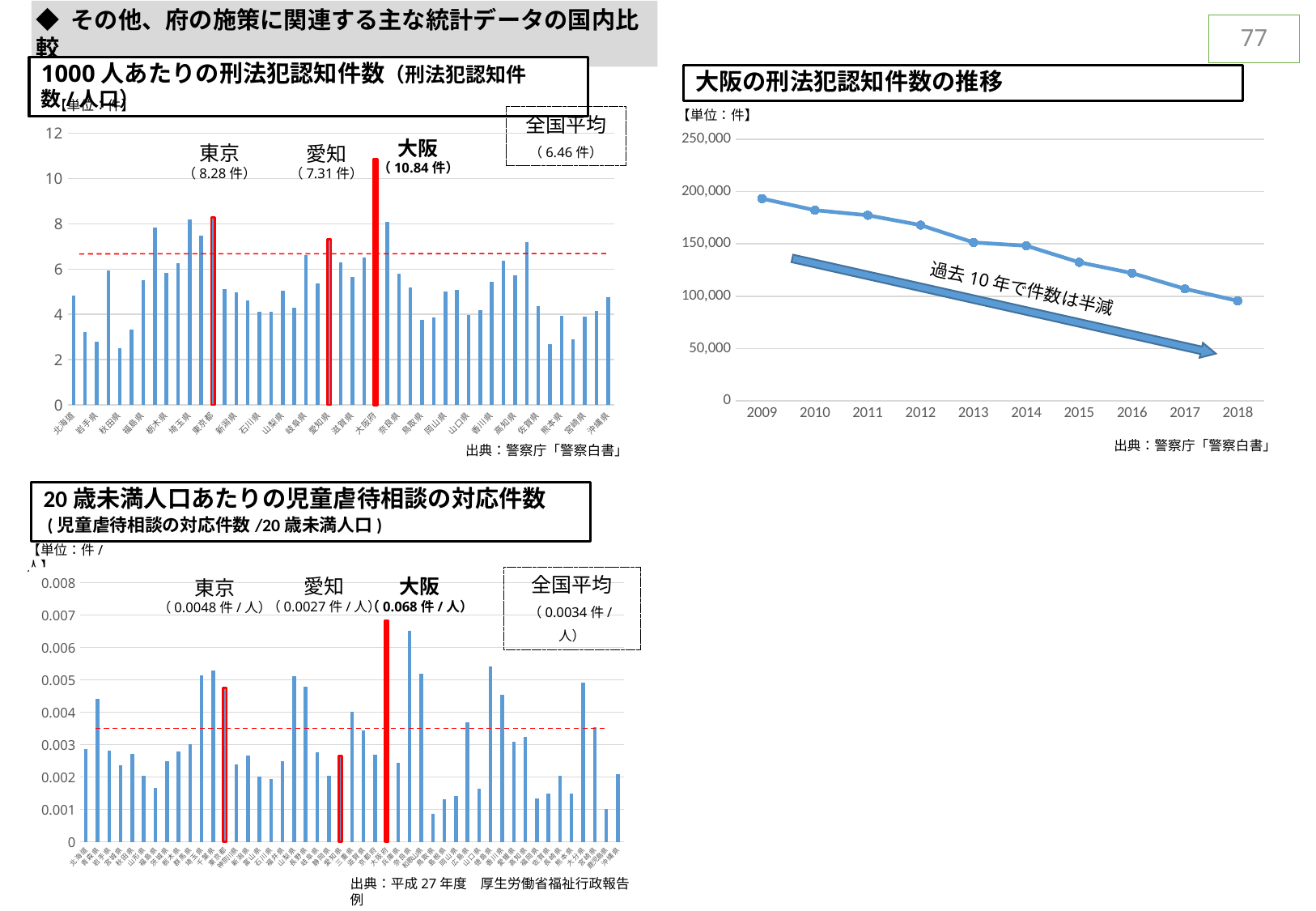
What kind of chart is the one titled 大阪の刑法犯認知件数の推移? line chart In the chart titled 20歳未満人口あたりの児童虐待相談の対応件数, what is the difference between the values for 東京 and 愛知? 0.0021件/人 In the chart titled 1000人あたりの刑法犯認知件数, what is the 全国平均 value shown? 6.46件 In the chart titled 1000人あたりの刑法犯認知件数, which has the larger value, 東京 or 愛知? 東京 In the chart titled 大阪の刑法犯認知件数の推移, is the value for 2018 greater or less than 100,000? less In the chart titled 1000人あたりの刑法犯認知件数, what is the value shown for 東京? 8.28件 In the chart titled 20歳未満人口あたりの児童虐待相談の対応件数, what is the value shown for 愛知? 0.0027件/人 In the chart titled 1000人あたりの刑法犯認知件数, what is the value shown for 大阪? 10.84件 In the chart titled 大阪の刑法犯認知件数の推移, do the values rise or fall from 2009 to 2018? fall How many years are plotted in the chart titled 大阪の刑法犯認知件数の推移? 10 In the chart titled 1000人あたりの刑法犯認知件数, what is the difference between the values for 大阪 and 東京? 2.56件 What kind of chart is the one titled 1000人あたりの刑法犯認知件数? bar chart